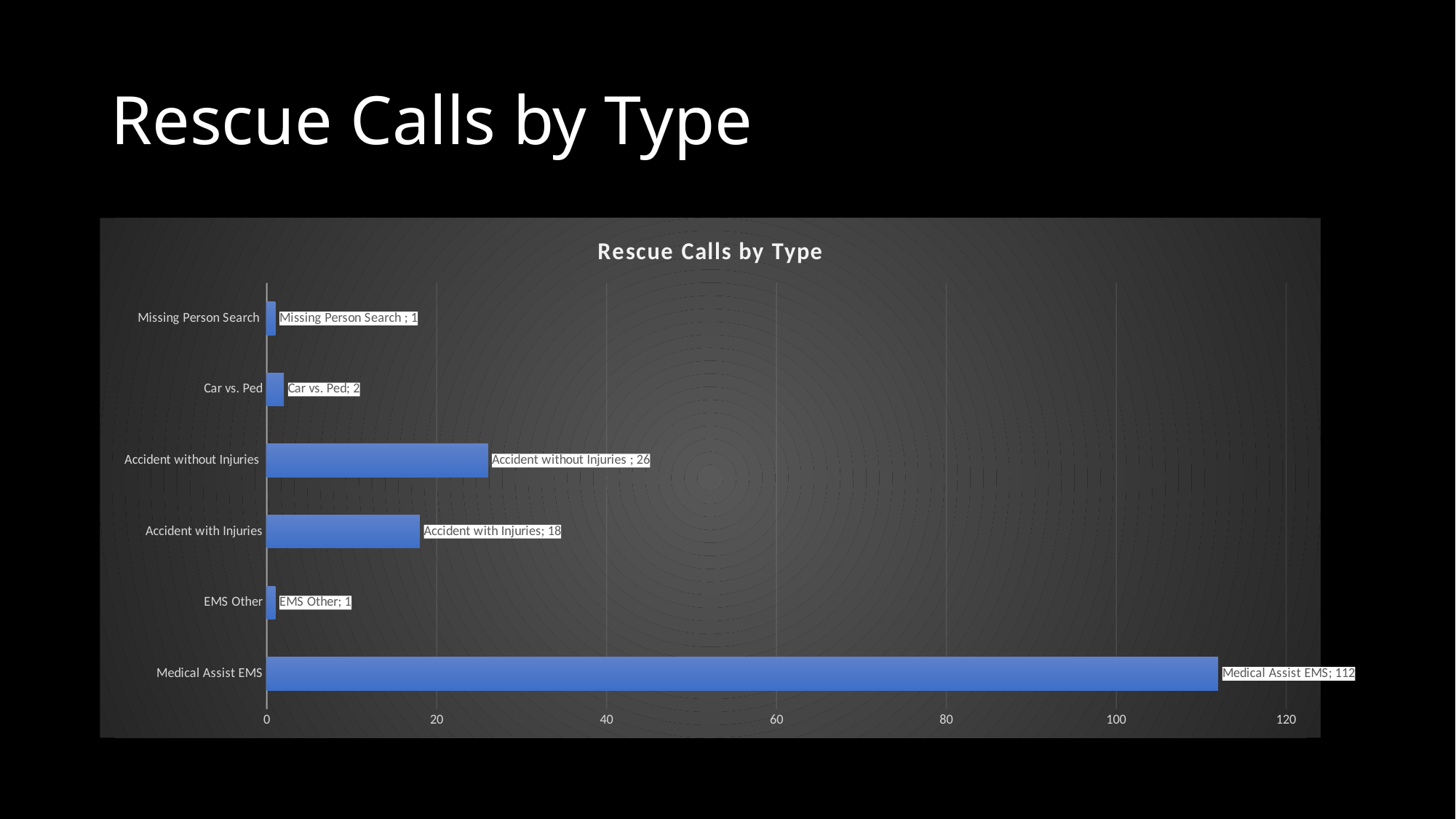
Which is larger, Accident with Injuries or Car vs. Ped? Accident with Injuries What is the value for Accident without Injuries? 26 What is the value for Accident with Injuries? 18 What is the value for Medical Assist EMS? 112 What is the title of the chart? Rescue Calls by Type What kind of chart is shown? bar chart How many categories are shown in the chart? 6 What is the value for Car vs. Ped? 2 What is the difference between Medical Assist EMS and Accident without Injuries? 86 Is the value for Medical Assist EMS greater or less than 100? greater Which category has the highest value? Medical Assist EMS What is the difference between Accident without Injuries and Accident with Injuries? 8